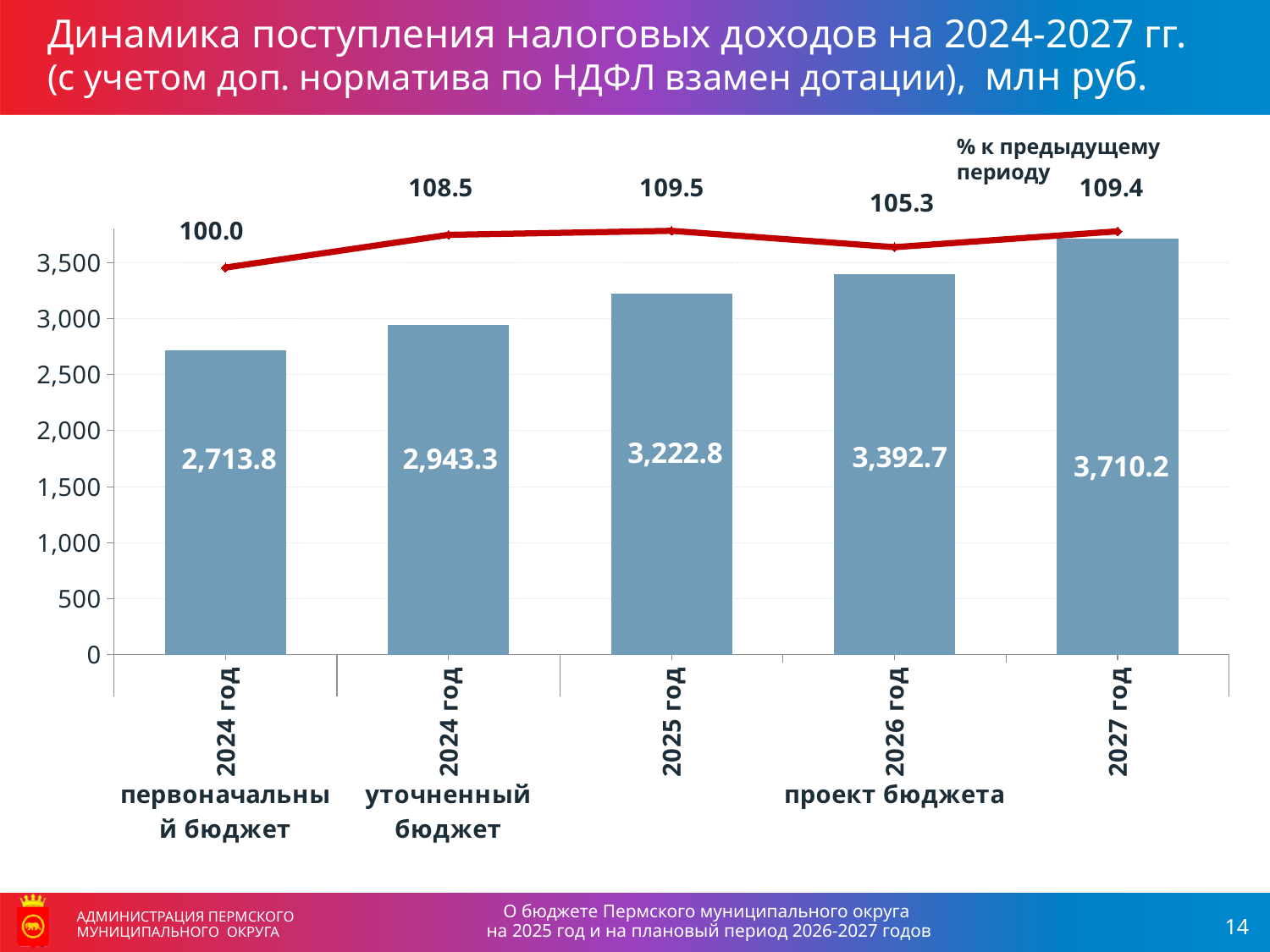
Do the tax revenue bars rise or fall from left to right along the x axis? rise What is the tax revenue value for 2027 год? 3,710.2 Which category has the highest tax revenue bar? 2027 год How many bars are plotted in the chart? 5 What is the difference between the tax revenue for 2027 год and the 2024 initial budget? 996.4 What is the '% к предыдущему периоду' value shown on the line for 2026 год? 105.3 Which is larger: the tax revenue for 2026 год or for 2025 год? 2026 год What is the tax revenue value for 2025 год? 3,222.8 What is the tax revenue value for the 2024 initial budget (первоначальный бюджет)? 2,713.8 What is the tax revenue value for the 2024 revised budget (уточненный бюджет)? 2,943.3 What is the difference between the '% к предыдущему периоду' values for 2025 год and 2026 год? 4.2 Which category has the lowest tax revenue bar? 2024 год первоначальный бюджет